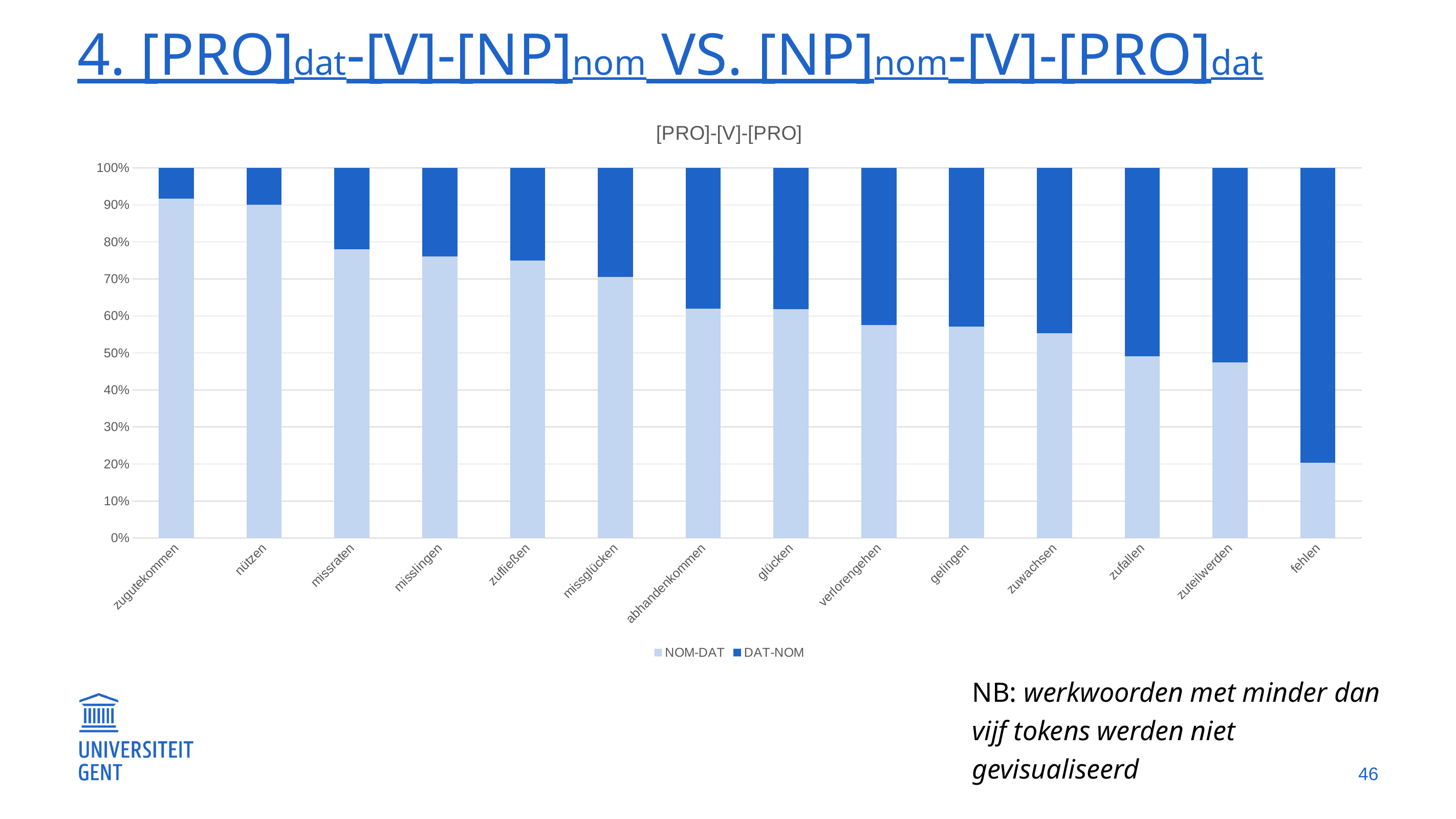
What kind of chart is shown on the slide? stacked bar chart Is the NOM-DAT share for zuteilwerden greater or less than 50%? less How many series does the chart legend list? 2 Which verb has the highest DAT-NOM share? fehlen Is the NOM-DAT share for fehlen greater or less than 30%? less How many verbs (categories) are shown on the x axis of the chart? 14 Which has the larger NOM-DAT share, nützen or gelingen? nützen Is the NOM-DAT share for missraten greater or less than 70%? greater Which verb has the lowest NOM-DAT share? fehlen What is the title of the chart? [PRO]-[V]-[PRO] Does the NOM-DAT share rise or fall moving from left to right along the x axis? fall